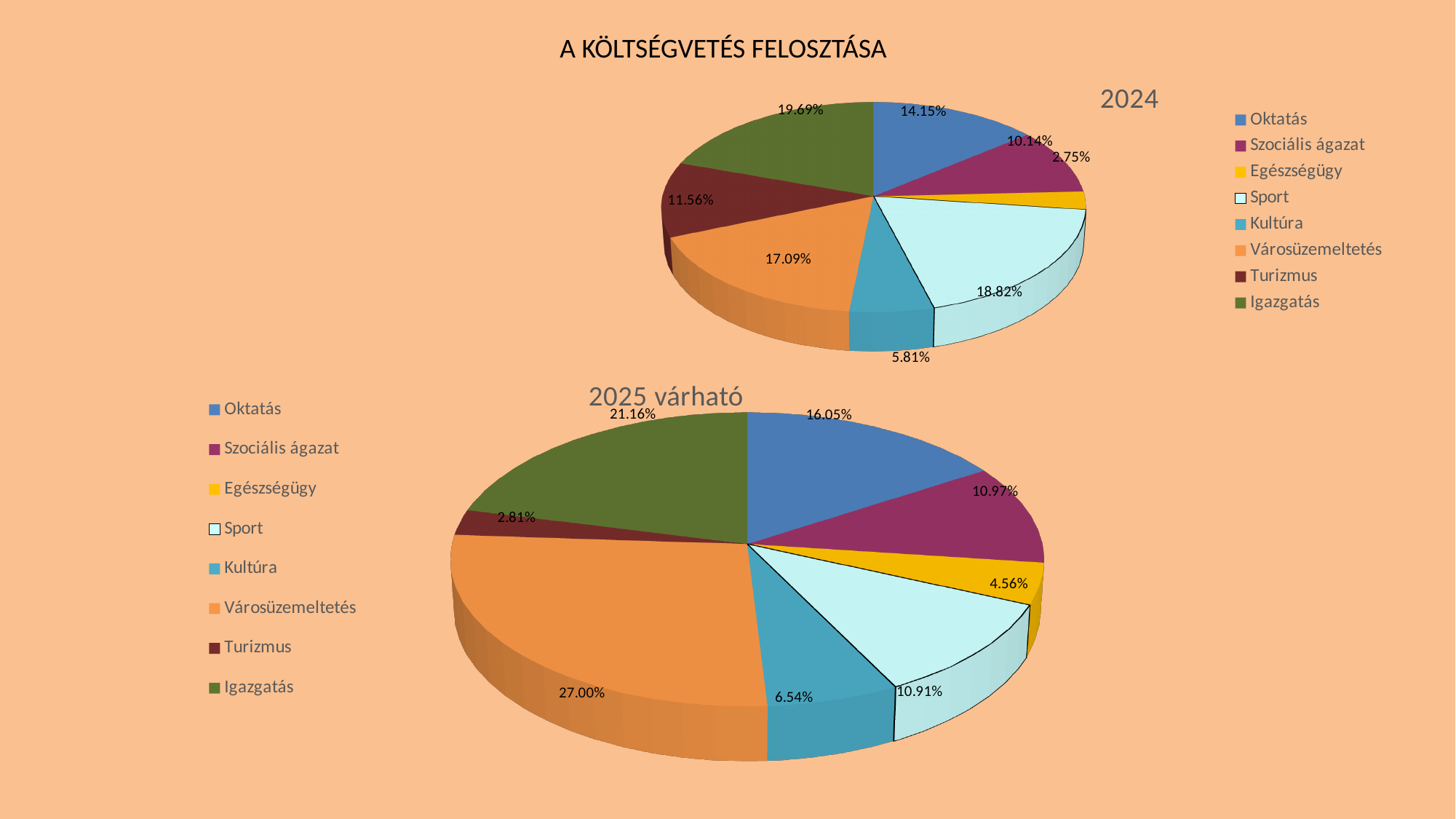
In the 2024 pie chart, which category has the smallest share? Egészségügy In the 2024 pie chart, what share does Sport have? 18.82% In the 2025 várható pie chart, what share does Városüzemeltetés have? 27.00% How many categories does the legend of the 2024 pie chart list? 8 In the 2024 pie chart, which category has the largest share? Igazgatás In the 2025 várható pie chart, which category has the largest share? Városüzemeltetés In the 2025 várható pie chart, what share does Turizmus have? 2.81% What is the title of the slide's chart area? A KÖLTSÉGVETÉS FELOSZTÁSA What type of chart is used for the 2025 várható data? Pie chart In the 2025 várható pie chart, which is larger: Oktatás or Szociális ágazat? Oktatás What is the difference between the Városüzemeltetés share in the 2025 várható chart and in the 2024 chart? 9.91% In the 2024 pie chart, what share does Igazgatás have? 19.69%